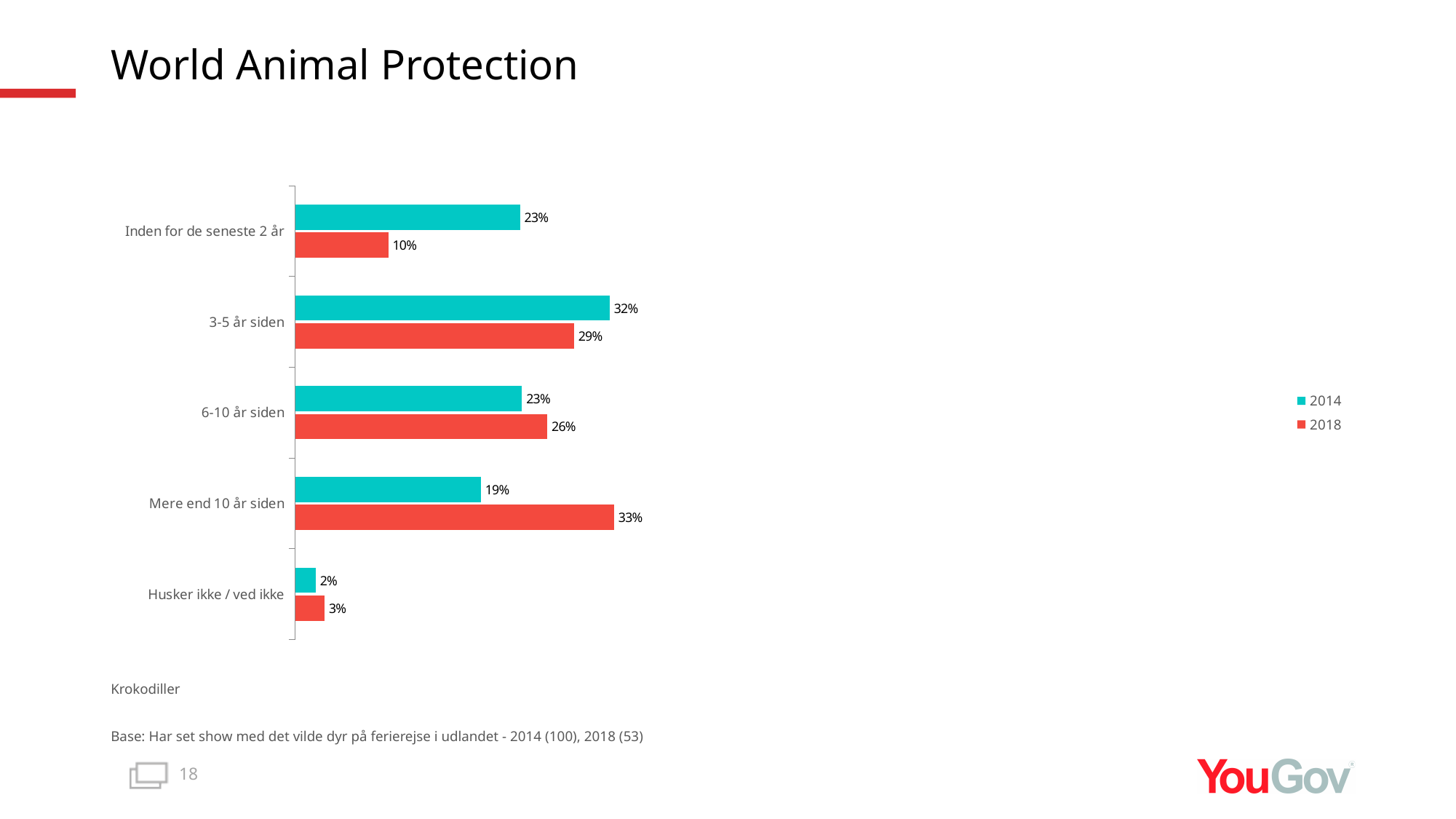
How many categories are shown on the chart? 5 What is the difference between the 2014 and 2018 values for "Inden for de seneste 2 år"? 13 percentage points Which category has the lowest 2018 value? Husker ikke / ved ikke What is the 2018 value for "3-5 år siden"? 29% What is the 2018 value for "Mere end 10 år siden"? 33% For "Mere end 10 år siden", which year has the larger value, 2014 or 2018? 2018 What kind of chart is shown on the slide? Bar chart Which colour represents the 2018 series in the legend? Red Which category has the highest 2014 value? 3-5 år siden How many series does the legend list? 2 For "6-10 år siden", which year has the larger value, 2014 or 2018? 2018 What is the 2014 value for "Inden for de seneste 2 år"? 23%